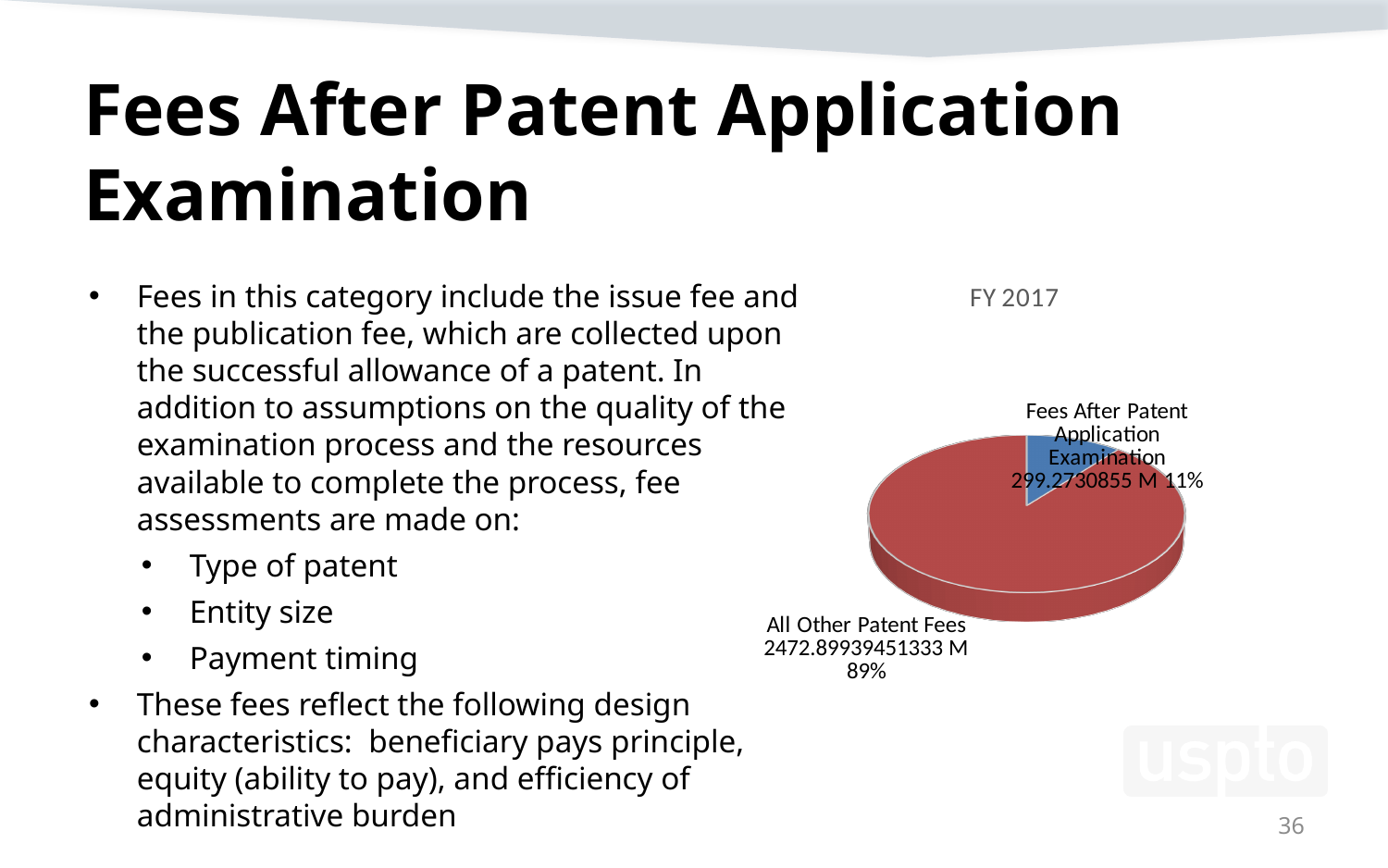
What is the title of the chart? FY 2017 Which slice is the smallest in the pie chart? Fees After Patent Application Examination What share of the pie is Fees After Patent Application Examination? 11% Which is larger, All Other Patent Fees or Fees After Patent Application Examination? All Other Patent Fees How many slices does the pie chart have? 2 What colour is the Fees After Patent Application Examination slice? blue What kind of chart is shown on the slide? pie chart What is the value shown for All Other Patent Fees? 2472.89939451333 M What is the value shown for Fees After Patent Application Examination? 299.2730855 M What share of the pie is All Other Patent Fees? 89% Which slice is the largest in the pie chart? All Other Patent Fees